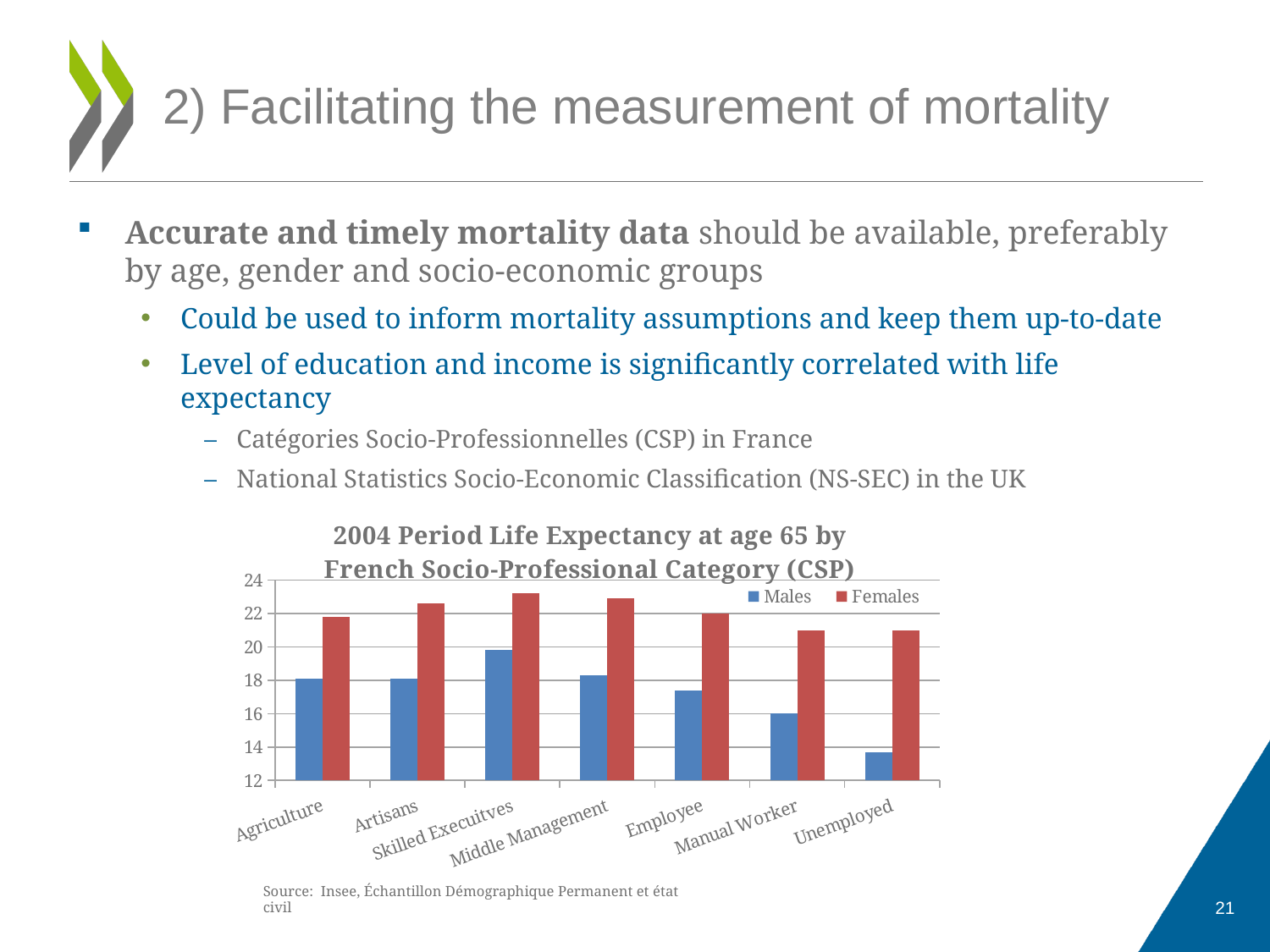
Is the Males value for Employee greater or less than 18? less Is the Females value for Agriculture greater or less than 20? greater What is the title of the chart? 2004 Period Life Expectancy at age 65 by French Socio-Professional Category (CSP) How many series does the chart's legend list? 2 How many socio-professional categories are shown on the x axis of the chart? 7 Which category has the lowest life expectancy for Males? Unemployed Is the Females value for Skilled Executives greater or less than 22? greater Which category has the highest life expectancy for Males? Skilled Executives Which is higher, the Males value for Skilled Executives or the Males value for Employee? Skilled Executives What type of chart is shown on the slide? Bar chart For Manual Worker, which series has the higher value, Males or Females? Females